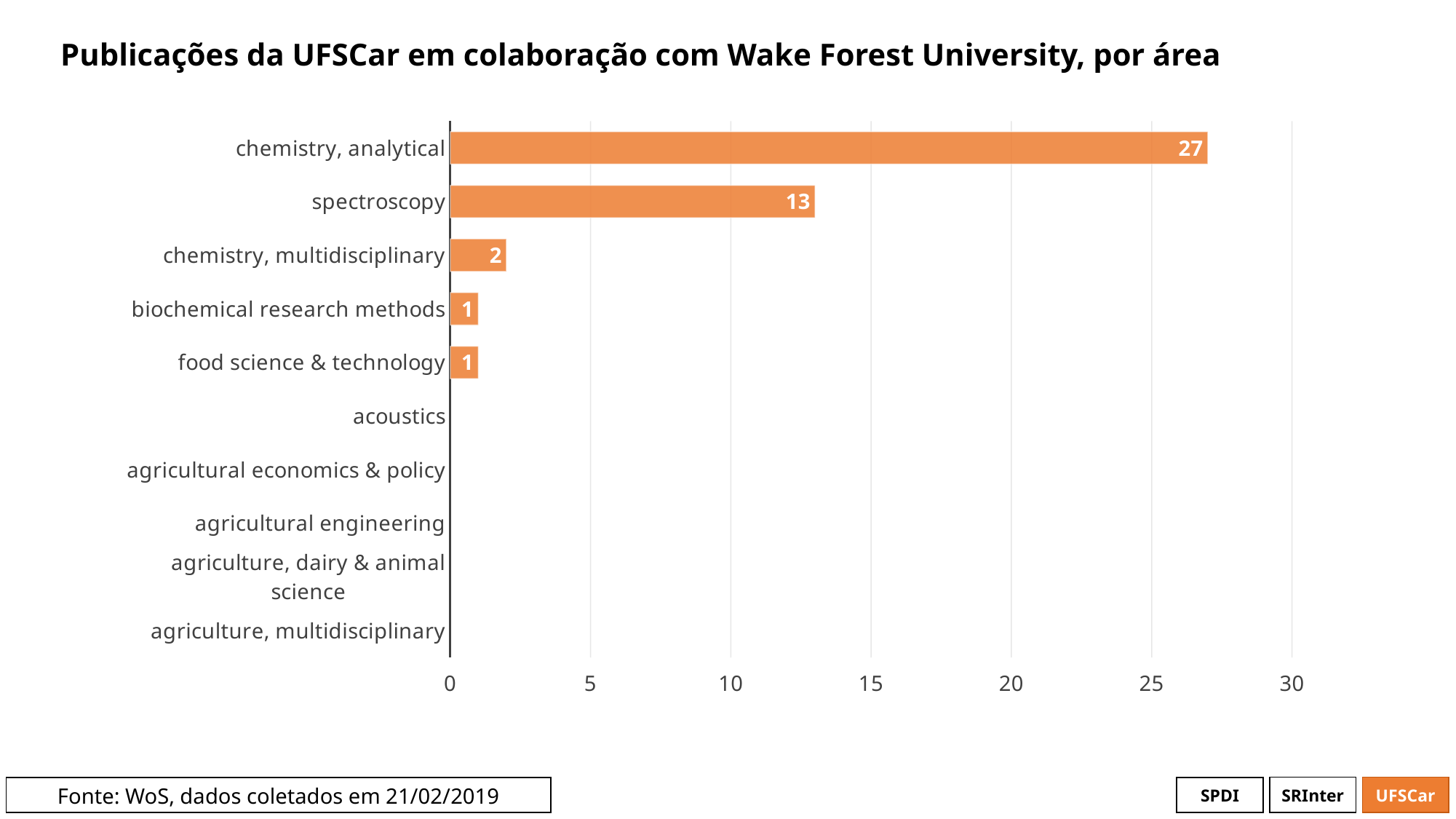
What is the value for spectroscopy? 13 Which category has the highest value? chemistry, analytical What is the value for biochemical research methods? 1 What is the difference between the values for chemistry, analytical and spectroscopy? 14 How many categories are listed on the y axis? 10 What is the value for chemistry, analytical? 27 What is the difference between the values for chemistry, multidisciplinary and food science & technology? 1 Is the value for chemistry, analytical greater or less than 25? greater What is the value for chemistry, multidisciplinary? 2 Which is larger, the value for spectroscopy or the value for chemistry, multidisciplinary? spectroscopy What is the title of the chart? Publicações da UFSCar em colaboração com Wake Forest University, por área What kind of chart is shown on the slide? bar chart